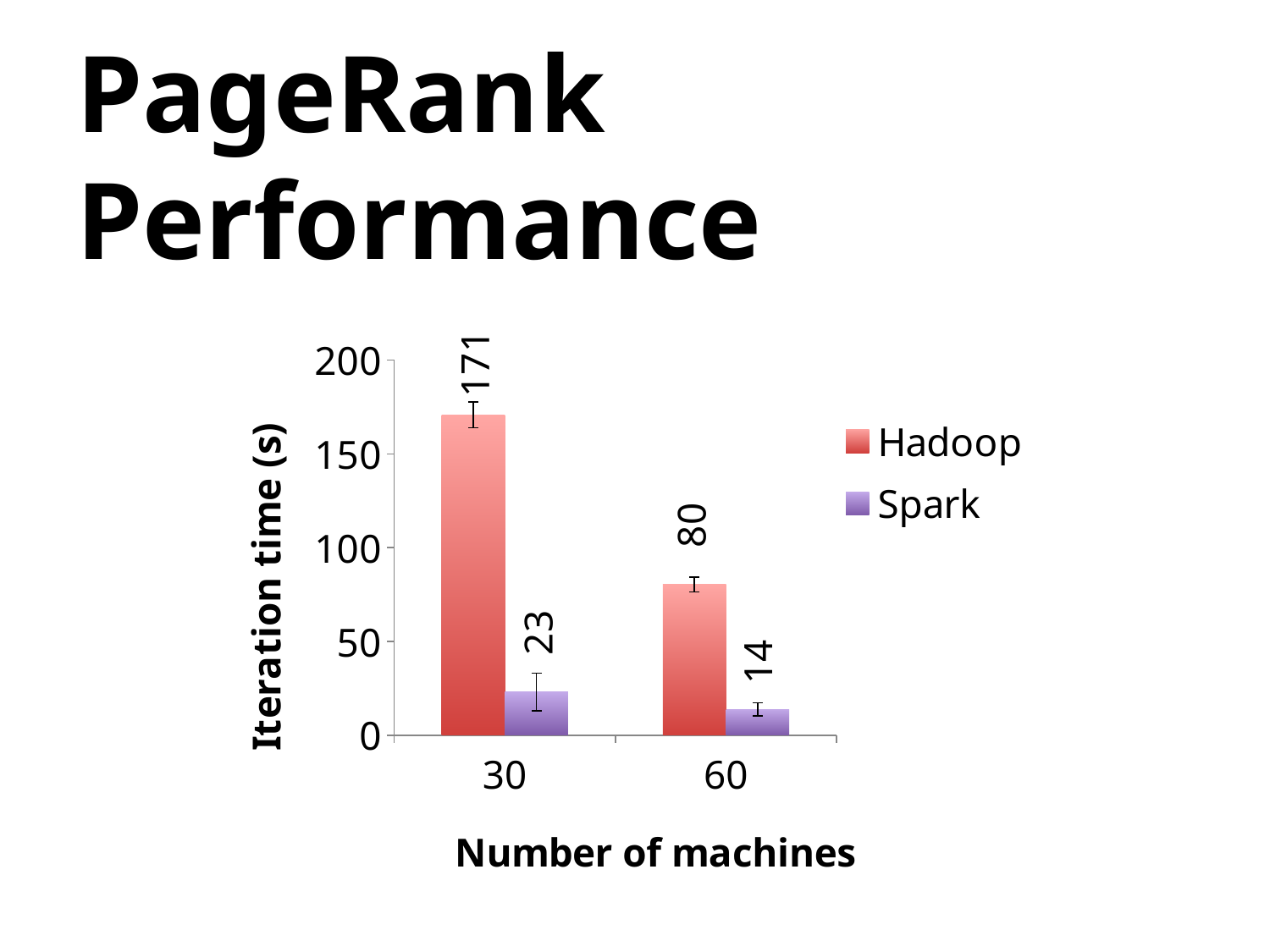
Which bar has the lowest iteration time? Spark with 60 machines What is the iteration time for Hadoop with 60 machines? 80 What is the iteration time for Spark with 30 machines? 23 What is the iteration time for Spark with 60 machines? 14 What kind of chart is shown? Bar chart What is the iteration time for Hadoop with 30 machines? 171 How many categories are shown on the x axis? 2 What is the label of the y axis? Iteration time (s) Which bar has the highest iteration time? Hadoop with 30 machines What is the difference between the Hadoop and Spark iteration times at 30 machines? 148 Which has a larger iteration time at 60 machines, Hadoop or Spark? Hadoop How many series does the legend list? 2